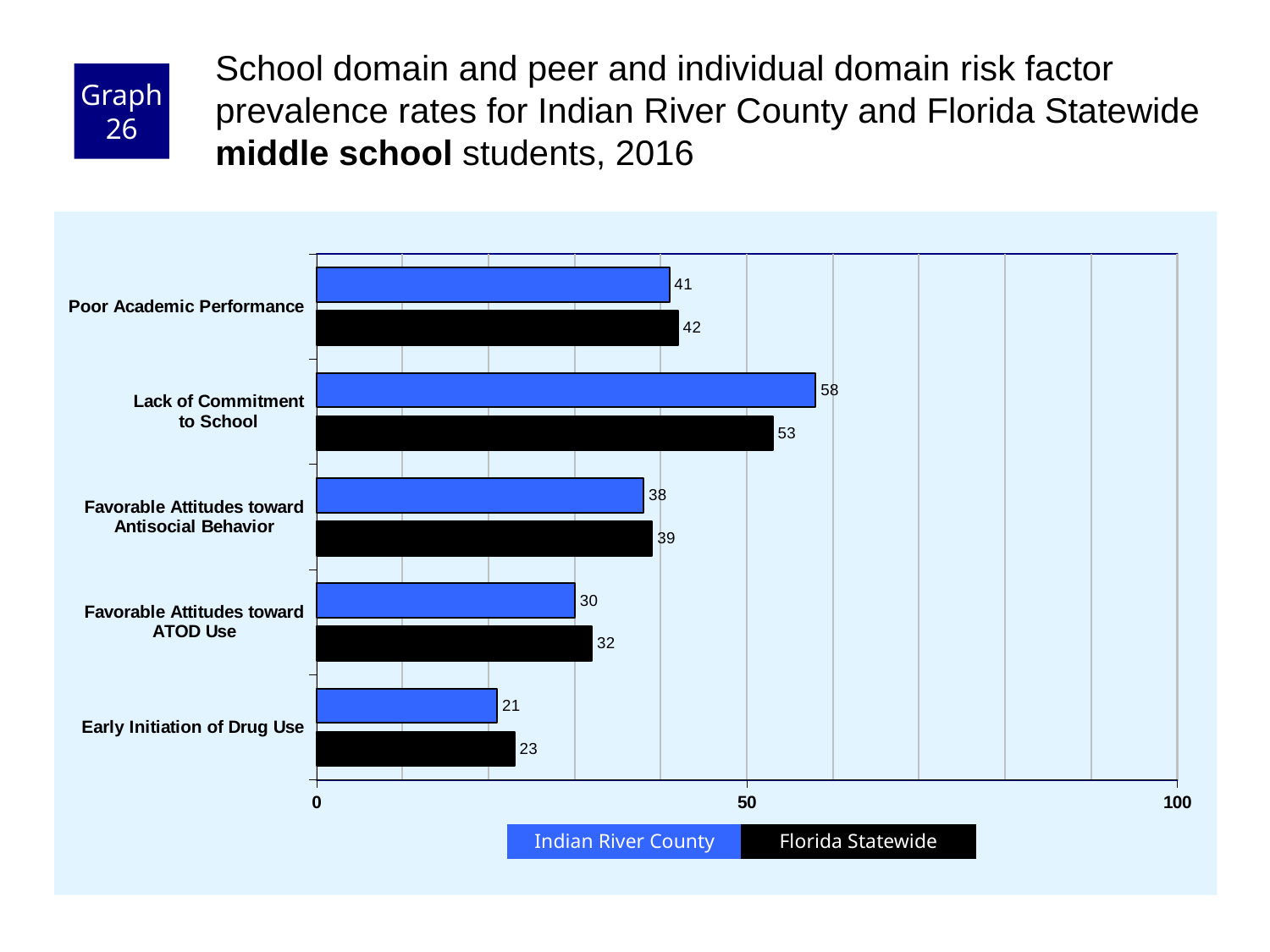
What is the Florida Statewide value for Early Initiation of Drug Use? 23 How many risk factors are shown on the chart? 5 What is the Indian River County value for Lack of Commitment to School? 58 What kind of chart is shown on the slide? bar chart Which risk factor has the lowest Florida Statewide value? Early Initiation of Drug Use What is the Florida Statewide value for Favorable Attitudes toward ATOD Use? 32 Which is larger for Favorable Attitudes toward ATOD Use: the Indian River County value or the Florida Statewide value? Florida Statewide What is the difference between the Indian River County and Florida Statewide values for Lack of Commitment to School? 5 Which colour represents Florida Statewide in the chart? black How many series does the legend list? 2 Is the Indian River County value for Poor Academic Performance greater or less than 50? less Which risk factor has the highest Indian River County value? Lack of Commitment to School